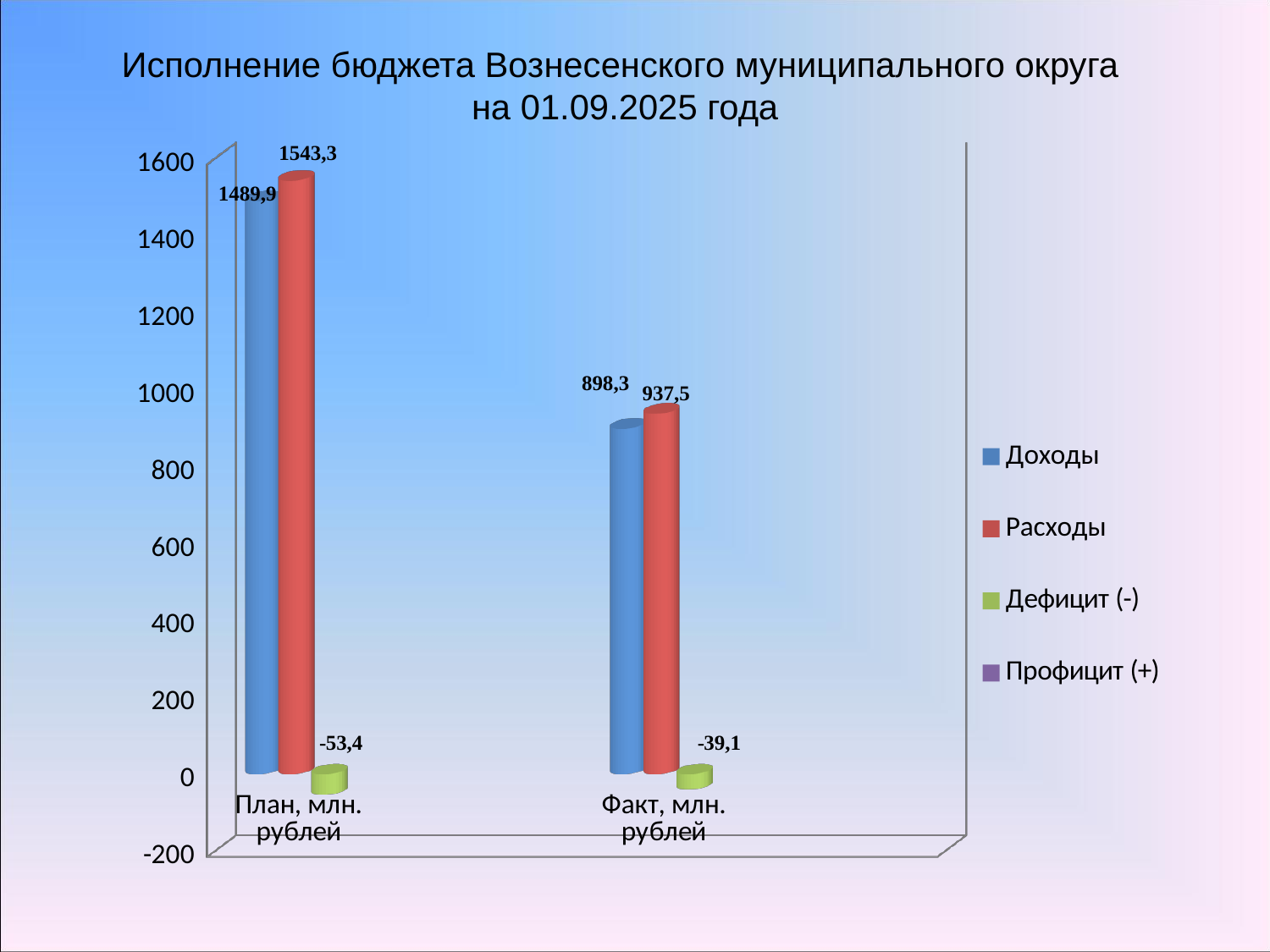
What is the value of Дефицит (-) for План, млн. рублей? -53,4 How many categories are shown on the x axis? 2 What is the difference between Расходы and Доходы for Факт, млн. рублей? 39,2 How many series does the legend list? 4 What is the value of Дефицит (-) for Факт, млн. рублей? -39,1 Which is larger for План, млн. рублей: Доходы or Расходы? Расходы What is the value of Доходы for Факт, млн. рублей? 898,3 What is the difference between Доходы for План, млн. рублей and Доходы for Факт, млн. рублей? 591,6 What type of chart is shown on the slide? Bar chart What is the value of Доходы for План, млн. рублей? 1489,9 What is the value of Расходы for План, млн. рублей? 1543,3 What is the value of Расходы for Факт, млн. рублей? 937,5